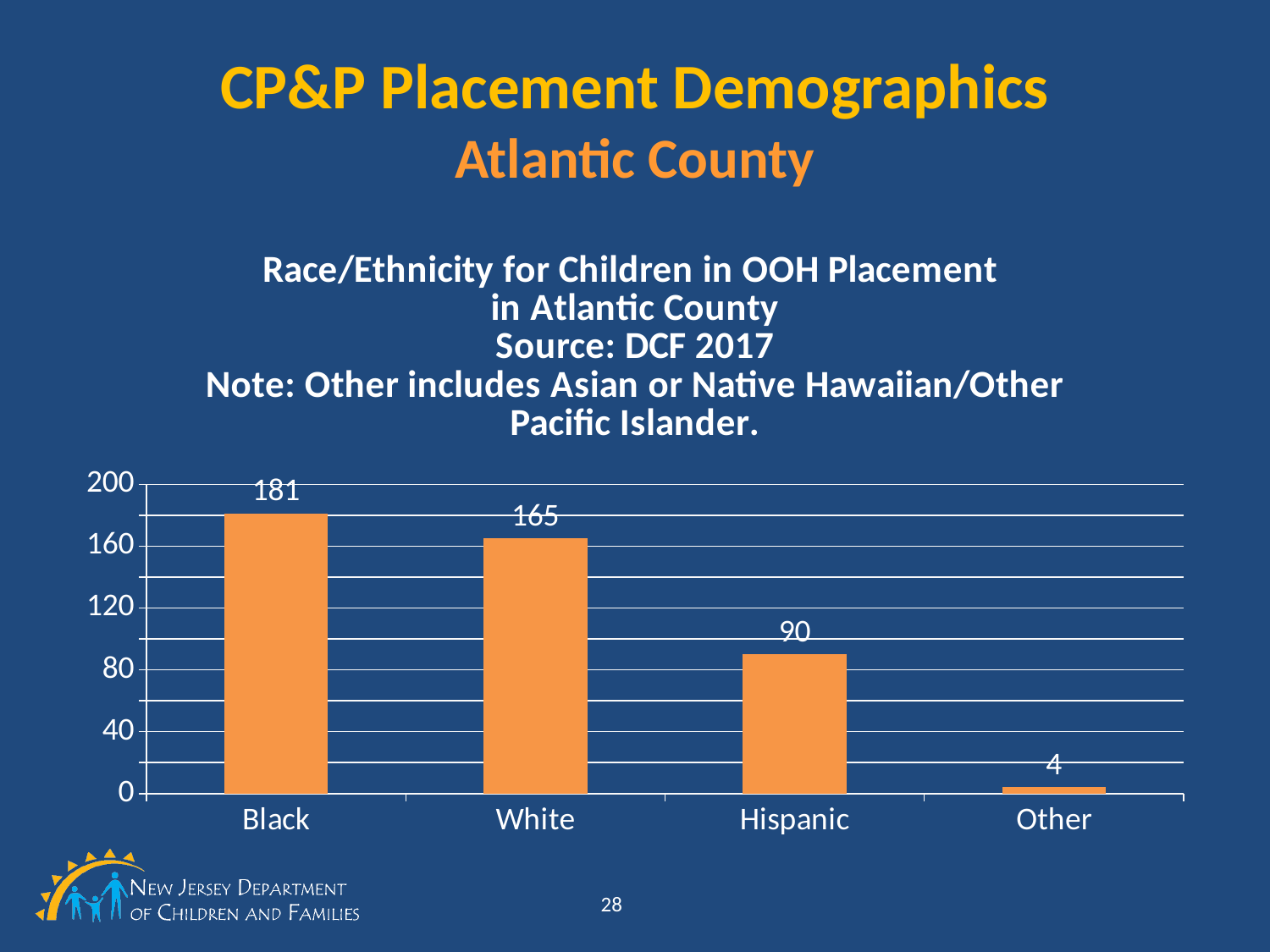
Is the value for Hispanic greater or less than 120? less Which is larger, the value for Hispanic or the value for Other? Hispanic What is the difference between the values for White and Hispanic? 75 What is the difference between the values for Black and White? 16 What is the value for White? 165 What is the value for Black? 181 How many categories are shown on the x axis? 4 Which category has the lowest value? Other Which category has the highest value? Black What is the value for Hispanic? 90 What is the value for Other? 4 What kind of chart is shown on the slide? bar chart